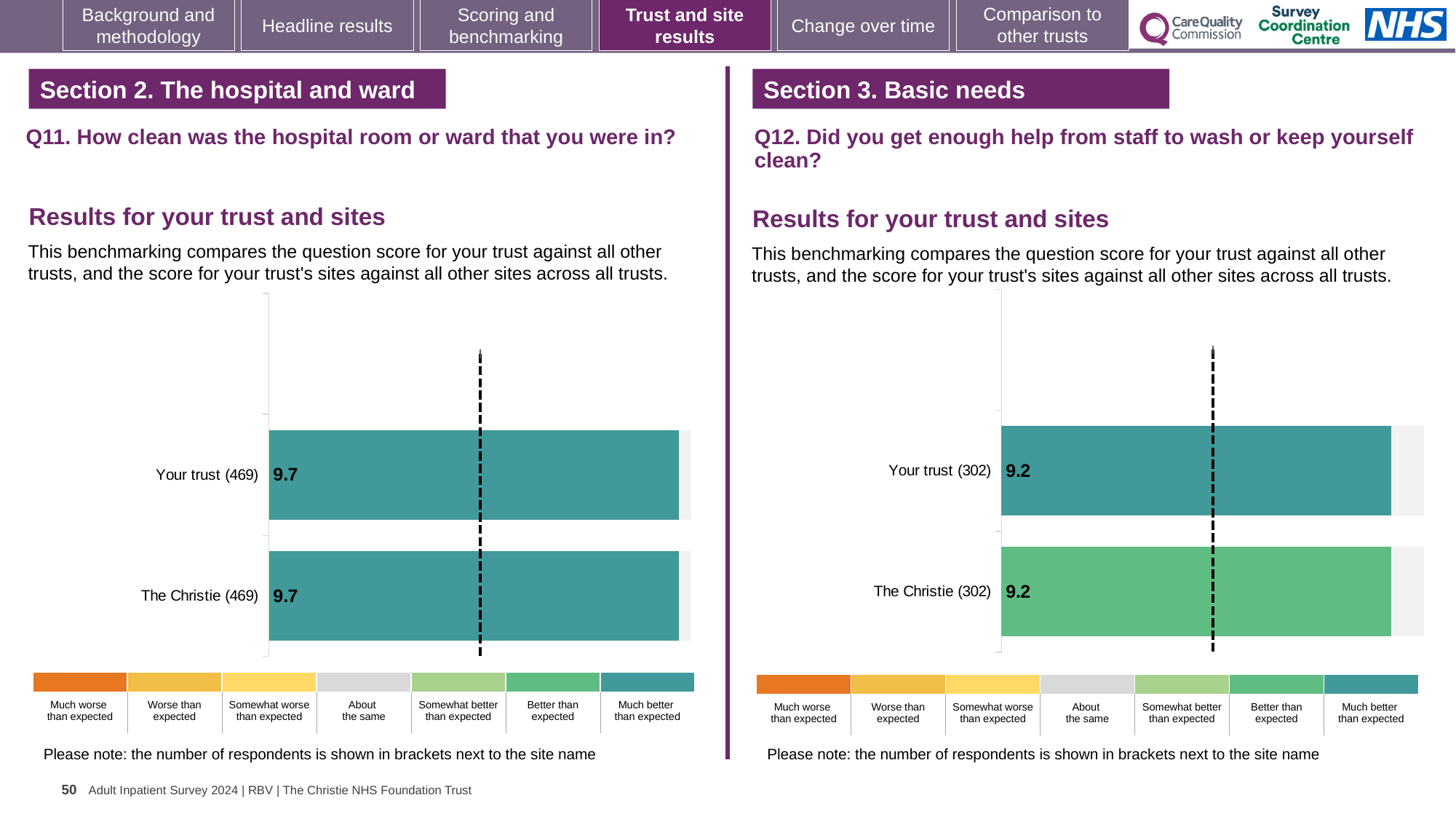
In the Q11 chart on the left, which benchmark category does the colour of the Your trust (469) bar correspond to in the key below? Much better than expected In the Q11 chart on the left, what is the score for The Christie (469)? 9.7 In the Q12 chart on the right, what is the score for Your trust (302)? 9.2 In the Q11 chart on the left, what is the difference between the score for Your trust (469) and the score for The Christie (469)? 0 In the Q12 chart on the right, what is the difference between the score for Your trust (302) and the score for The Christie (302)? 0 In the Q12 chart on the right, what is the score for The Christie (302)? 9.2 How many bars are plotted in the Q11 chart on the left? 2 In the Q12 chart on the right, which benchmark category does the colour of The Christie (302) bar correspond to in the key below? Better than expected What kind of chart is used for the Q11 results on the left? Bar chart How many respondents are shown in brackets for Your trust in the Q12 chart on the right? 302 How many bars are plotted in the Q12 chart on the right? 2 In the Q11 chart on the left, what is the score for Your trust (469)? 9.7